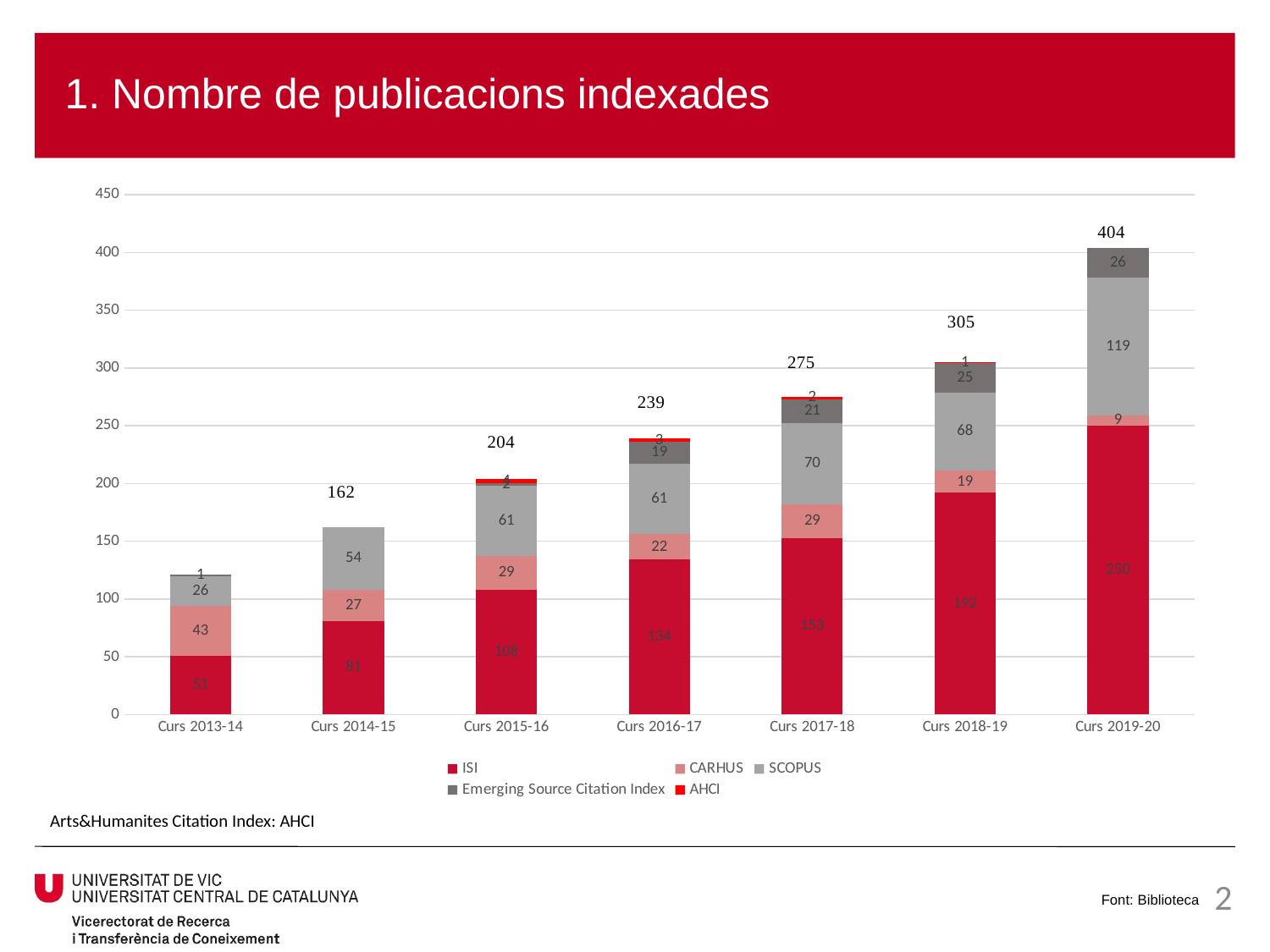
What is the difference between the total for Curs 2019-20 and the total for Curs 2018-19? 99 Which academic year has the lowest ISI value? Curs 2013-14 What is the total shown above the stacked bar for Curs 2018-19? 305 How many academic years are shown on the x axis? 7 Is the total for Curs 2013-14 greater or less than 150? less How many series does the legend list? 5 Which academic year has the highest total number of indexed publications? Curs 2019-20 Which is larger, the SCOPUS value for Curs 2019-20 or the SCOPUS value for Curs 2017-18? Curs 2019-20 What is the CARHUS value for Curs 2013-14? 43 What is the SCOPUS value for Curs 2017-18? 70 What is the ISI value for Curs 2019-20? 250 Do the total values rise or fall from Curs 2013-14 to Curs 2019-20? rise